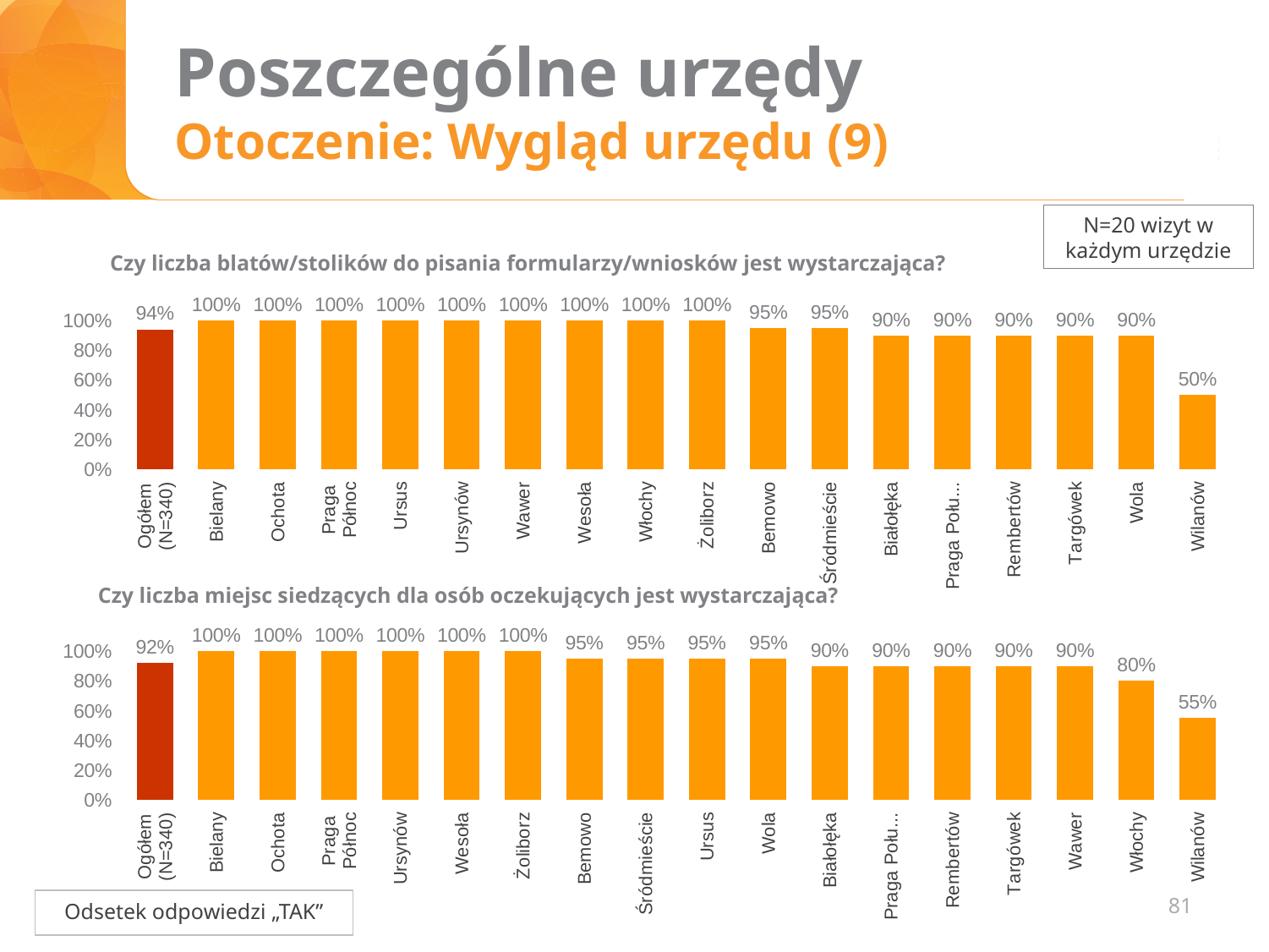
What type of chart is the bottom chart (Czy liczba miejsc siedzących...)? Bar chart In the top chart (Czy liczba blatów/stolików do pisania formularzy/wniosków jest wystarczająca?), what is the value for Wilanów? 50% In the bottom chart (Czy liczba miejsc siedzących...), which category has the lowest value? Wilanów In the bottom chart (Czy liczba miejsc siedzących dla osób oczekujących jest wystarczająca?), what is the value for Włochy? 80% In the top chart (Czy liczba blatów/stolików...), what is the difference between Bemowo and Wilanów? 45% In the bottom chart (Czy liczba miejsc siedzących...), which is larger, the value for Ursus or the value for Wawer? Ursus In the top chart (Czy liczba blatów/stolików...), what is the value for Ogółem (N=340)? 94% In the top chart (Czy liczba blatów/stolików...), which category has the lowest value? Wilanów In the bottom chart (Czy liczba miejsc siedzących...), what is the difference between Włochy and Wilanów? 25% In the bottom chart (Czy liczba miejsc siedzących...), what is the value for Ogółem (N=340)? 92% In the top chart (Czy liczba blatów/stolików...), how many bars are plotted? 18 According to the note in the top right of the slide, how many visits were made in each office? N=20